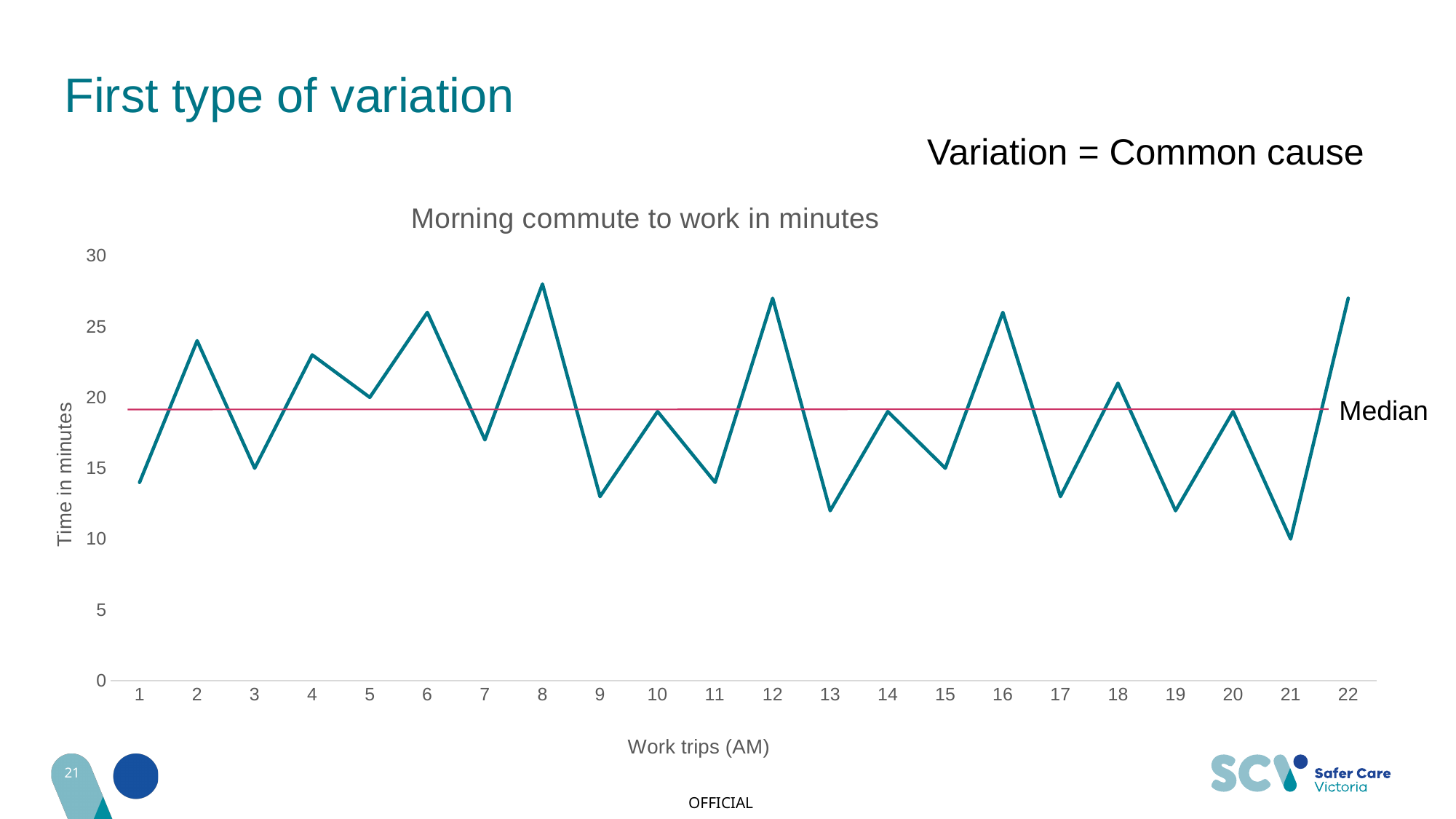
Which has the larger commute time, work trip 9 or work trip 8? work trip 8 Which work trip has the lowest commute time? 21 Is the value for work trip 13 greater or less than 15? less Is the value for work trip 8 greater or less than 25? greater Is the value for work trip 6 greater or less than 25? greater What is the commute time for work trip 5? 20 What is the commute time for work trip 21? 10 Which has the larger commute time, work trip 2 or work trip 3? work trip 2 How many work trips are plotted on the x axis? 22 What does the horizontal pink line across the chart represent? Median What kind of chart is shown on the slide? line chart What is the title of the chart? Morning commute to work in minutes